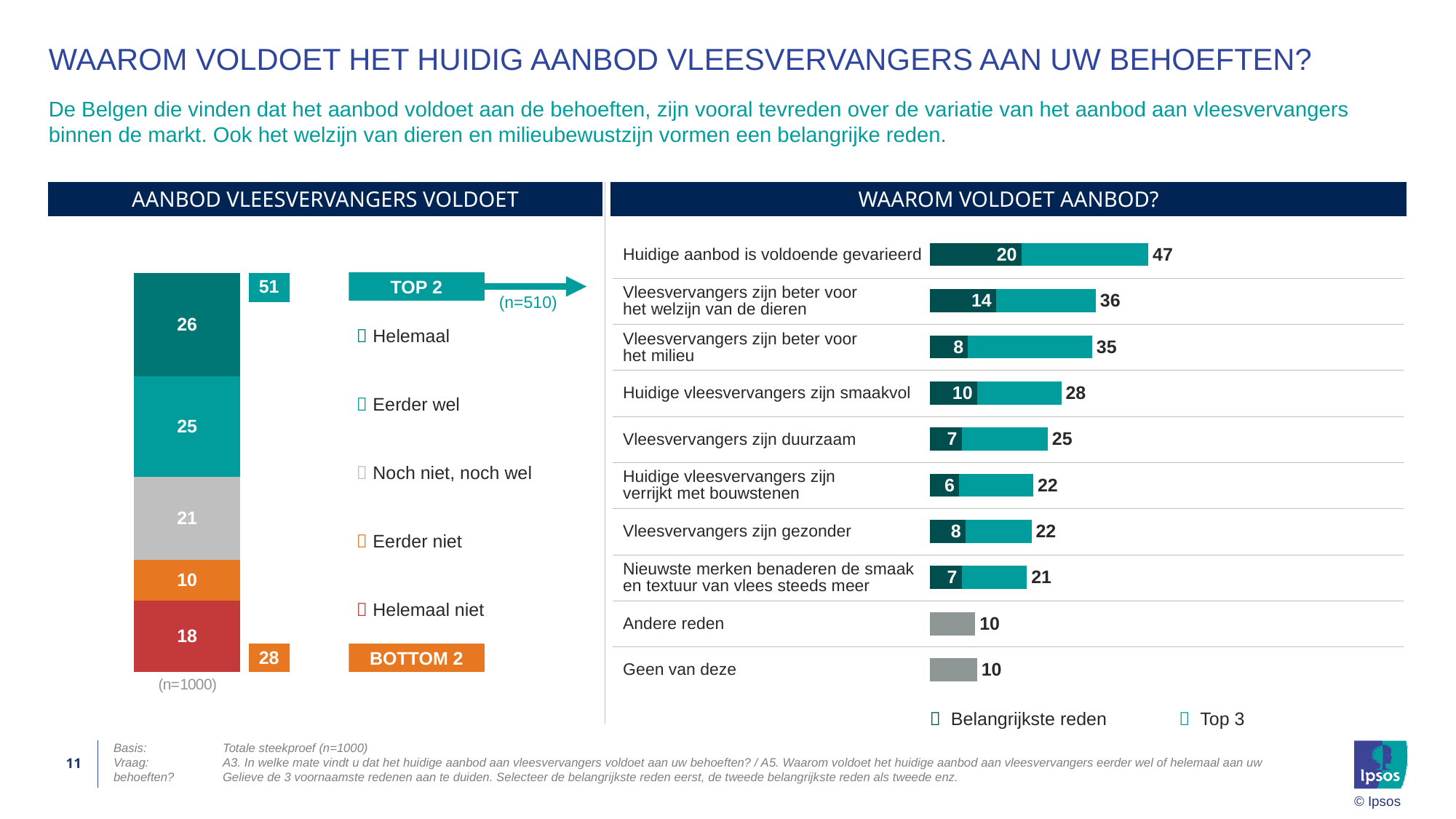
How many reasons (categories) are shown in the chart 'WAAROM VOLDOET AANBOD?'? 10 What kind of chart is 'WAAROM VOLDOET AANBOD?'? Bar chart In the chart 'AANBOD VLEESVERVANGERS VOLDOET', what is the TOP 2 value? 51 In the chart 'WAAROM VOLDOET AANBOD?', what is the 'Belangrijkste reden' value for 'Vleesvervangers zijn beter voor het welzijn van de dieren'? 14 In the chart 'AANBOD VLEESVERVANGERS VOLDOET', what is the value for 'Noch niet, noch wel'? 21 In the chart 'AANBOD VLEESVERVANGERS VOLDOET', what is the difference between 'Helemaal niet' and 'Eerder niet'? 8 In the chart 'WAAROM VOLDOET AANBOD?', what is the Top 3 value for 'Huidige aanbod is voldoende gevarieerd'? 47 In the chart 'WAAROM VOLDOET AANBOD?', which has a larger 'Belangrijkste reden' value: 'Huidige vleesvervangers zijn smaakvol' or 'Vleesvervangers zijn duurzaam'? Huidige vleesvervangers zijn smaakvol In the chart 'WAAROM VOLDOET AANBOD?', which reason has the highest Top 3 value? Huidige aanbod is voldoende gevarieerd In the chart 'AANBOD VLEESVERVANGERS VOLDOET', which category has the lowest value? Eerder niet In the chart 'WAAROM VOLDOET AANBOD?', what is the difference between the Top 3 values for 'Huidige aanbod is voldoende gevarieerd' and 'Vleesvervangers zijn beter voor het milieu'? 12 How many series does the legend of the chart 'WAAROM VOLDOET AANBOD?' list? 2